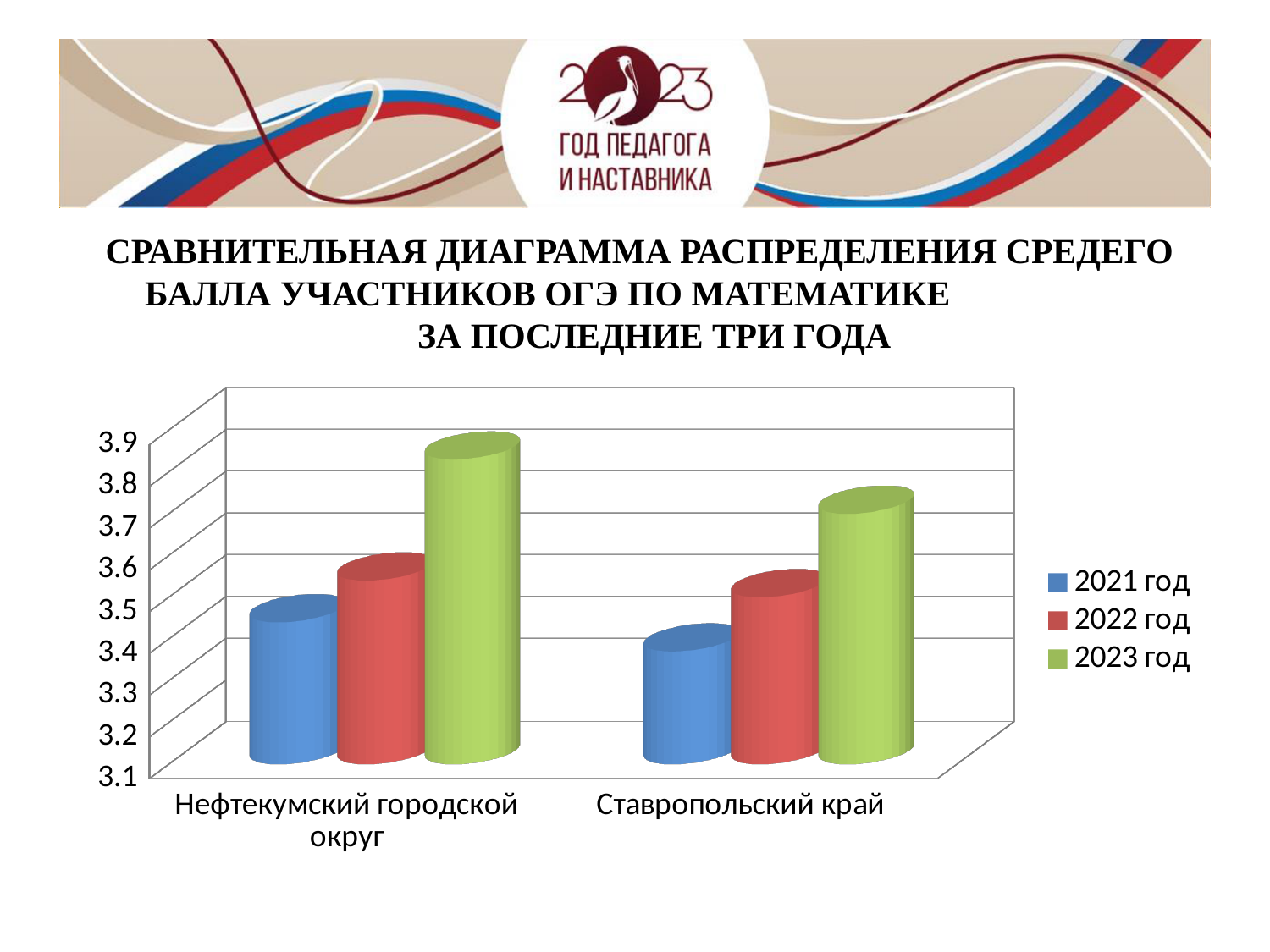
What kind of chart is shown on the slide? bar chart Do the values for Нефтекумский городской округ rise or fall from 2021 год to 2023 год? rise Is the value for 2023 год in Ставропольский край greater or less than 3.6? greater How many series does the legend list? 3 Which series is shown in green in the legend? 2023 год Which is larger: the 2023 год value for Нефтекумский городской округ or for Ставропольский край? Нефтекумский городской округ Is the value for 2021 год in Нефтекумский городской округ greater or less than 3.6? less Which category has the highest bar for 2023 год? Нефтекумский городской округ Is the value for 2021 год in Ставропольский край greater or less than 3.5? less Which bar is the lowest on the chart? 2021 год for Ставропольский край How many categories are shown on the x axis? 2